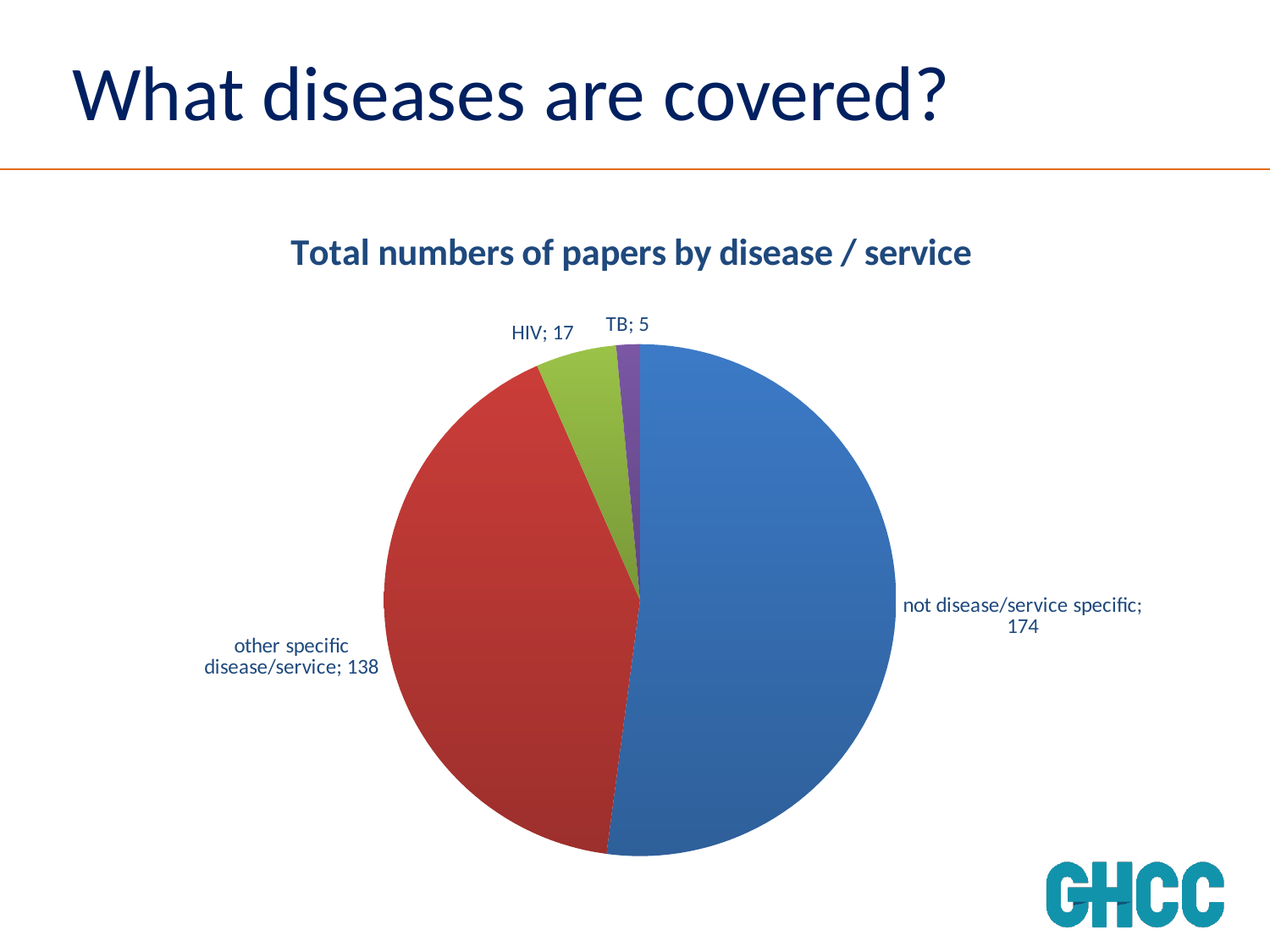
Which has more papers, HIV or TB? HIV How many papers are in the 'other specific disease/service' category? 138 How many papers are in the 'not disease/service specific' category? 174 How many papers are about TB? 5 How many papers are about HIV? 17 What is the difference between the number of 'not disease/service specific' papers and 'other specific disease/service' papers? 36 Which category has the largest number of papers? not disease/service specific What kind of chart is shown on the slide? pie chart How many slices does the pie chart have? 4 Which category has the smallest number of papers? TB What is the title of the chart? Total numbers of papers by disease / service What is the total number of papers across all slices of the pie? 334